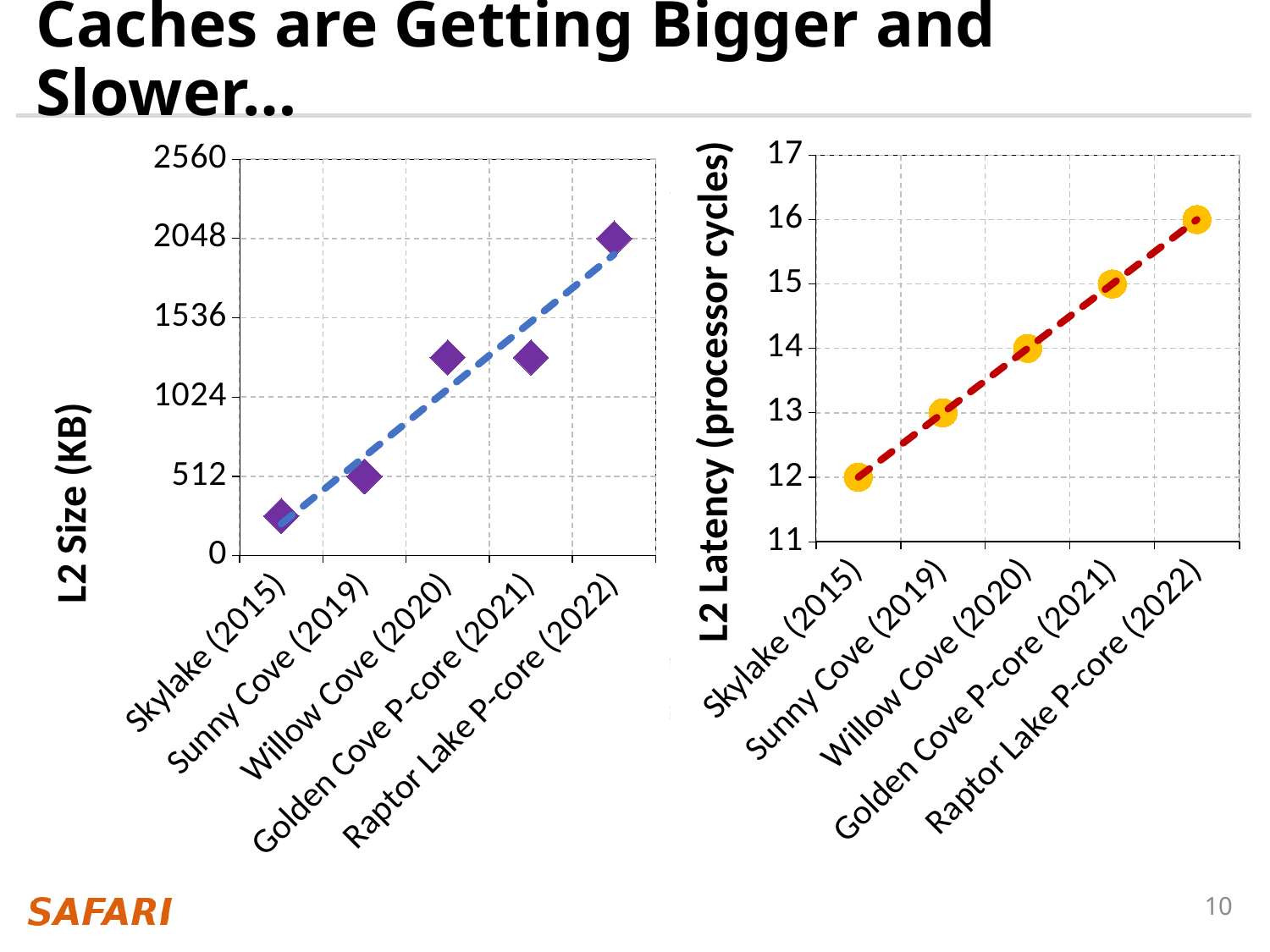
In the left chart (L2 Size), is the value for Skylake (2015) greater or less than 512? less In the right chart (L2 Latency), what is the L2 latency for Willow Cove (2020)? 14 In the left chart (L2 Size), what is the L2 size in KB for Sunny Cove (2019)? 512 In the right chart (L2 Latency), what is the L2 latency in processor cycles for Raptor Lake P-core (2022)? 16 In the right chart (L2 Latency), what is the L2 latency in processor cycles for Skylake (2015)? 12 In the right chart (L2 Latency), do the values rise or fall from Skylake (2015) to Raptor Lake P-core (2022)? rise In the left chart (L2 Size), which processor has the largest L2 size? Raptor Lake P-core (2022) In the left chart (L2 Size), which processor has the smallest L2 size? Skylake (2015) In the right chart (L2 Latency), how many processor generations are plotted? 5 In the left chart (L2 Size), what is the L2 size in KB for Raptor Lake P-core (2022)? 2048 In the right chart (L2 Latency), by how many processor cycles does the latency of Raptor Lake P-core (2022) exceed that of Skylake (2015)? 4 In the left chart (L2 Size), is the value for Willow Cove (2020) greater or less than 1024? greater